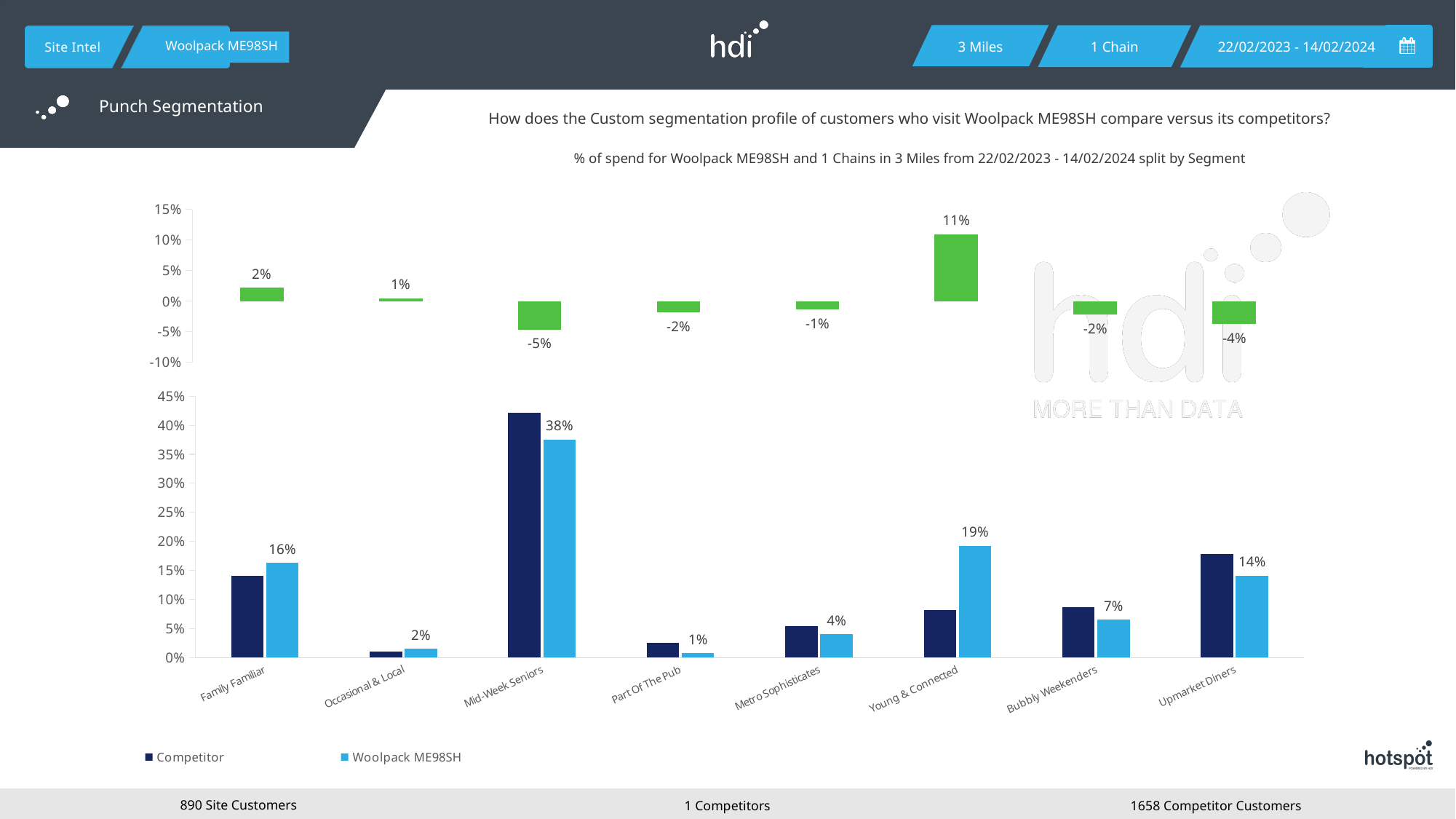
In the top chart, what is the value shown for Mid-Week Seniors? -5% In the bottom chart, which is larger for Upmarket Diners: the Competitor bar or the Woolpack ME98SH bar? Competitor In the bottom chart, what is the Woolpack ME98SH value for Mid-Week Seniors? 38% In the bottom chart, what is the Woolpack ME98SH value for Young & Connected? 19% In the bottom chart, what is the difference between the Woolpack ME98SH values for Mid-Week Seniors and Young & Connected? 19% In the bottom chart, is the Competitor value for Mid-Week Seniors greater or less than 40%? greater In the top chart, what is the value shown for Young & Connected? 11% How many series does the legend of the bottom chart list? 2 In the bottom chart, which segment has the lowest Woolpack ME98SH value? Part Of The Pub How many segments are shown on the x axis of the bottom chart? 8 In the bottom chart, which segment has the highest Woolpack ME98SH value? Mid-Week Seniors In the top chart, which segment has the lowest value? Mid-Week Seniors